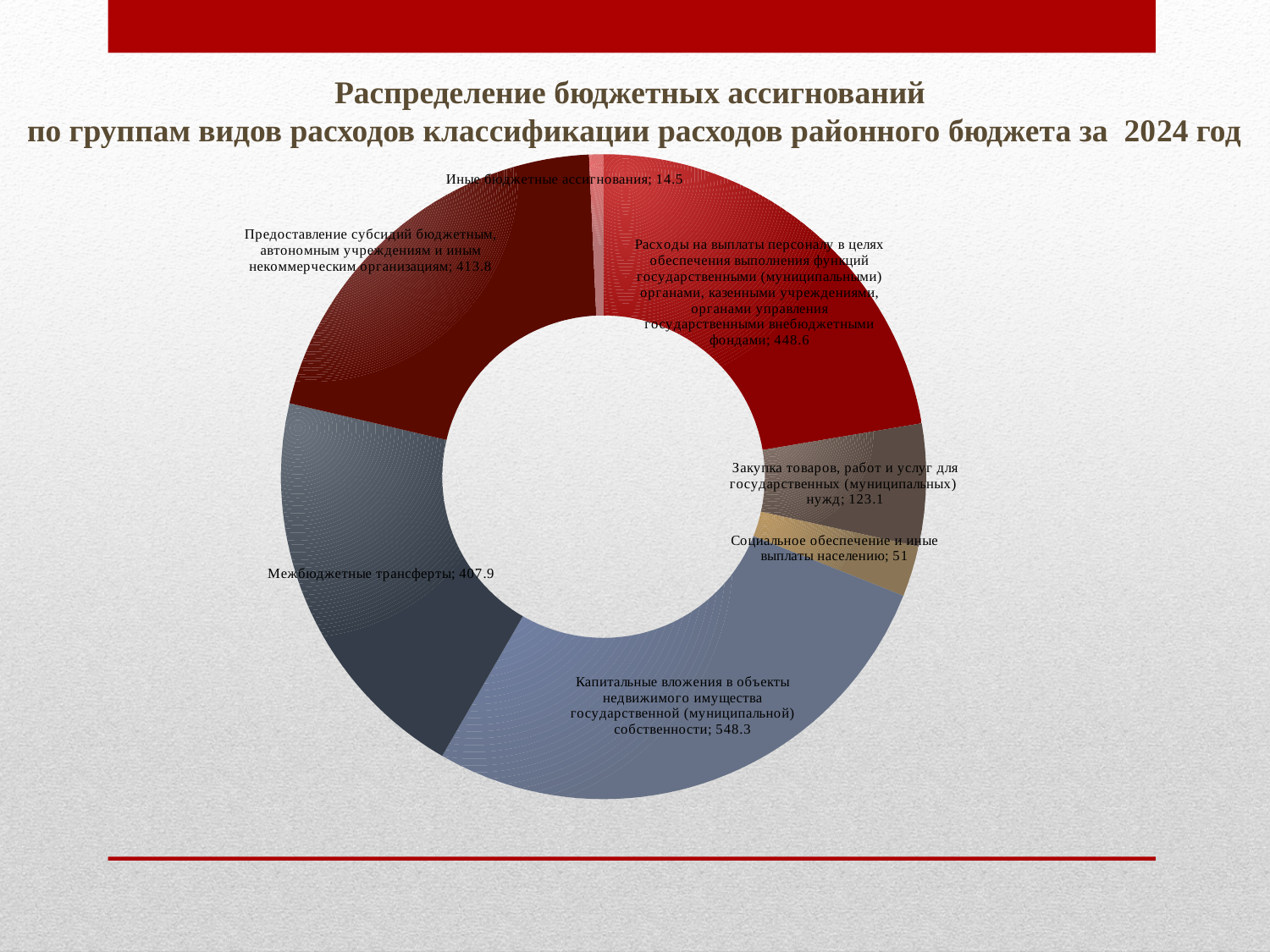
Which is larger: the value for Расходы на выплаты персоналу or the value for Закупка товаров, работ и услуг? Расходы на выплаты персоналу What is the value for Межбюджетные трансферты? 407.9 What is the value for Социальное обеспечение и иные выплаты населению? 51 What type of chart is shown on the slide? Pie chart (doughnut) Which category has the smallest value? Иные бюджетные ассигнования Which year does the chart title say the budget allocations are for? 2024 What is the difference between the value for Расходы на выплаты персоналу (448.6) and the value for Предоставление субсидий бюджетным, автономным учреждениям и иным некоммерческим организациям (413.8)? 34.8 What is the total of all the values shown in the chart? 2007.2 Which category has the largest value? Капитальные вложения в объекты недвижимого имущества государственной (муниципальной) собственности What is the value for Капитальные вложения в объекты недвижимого имущества государственной (муниципальной) собственности? 548.3 What is the value for Закупка товаров, работ и услуг для государственных (муниципальных) нужд? 123.1 How many categories does the chart show? 7